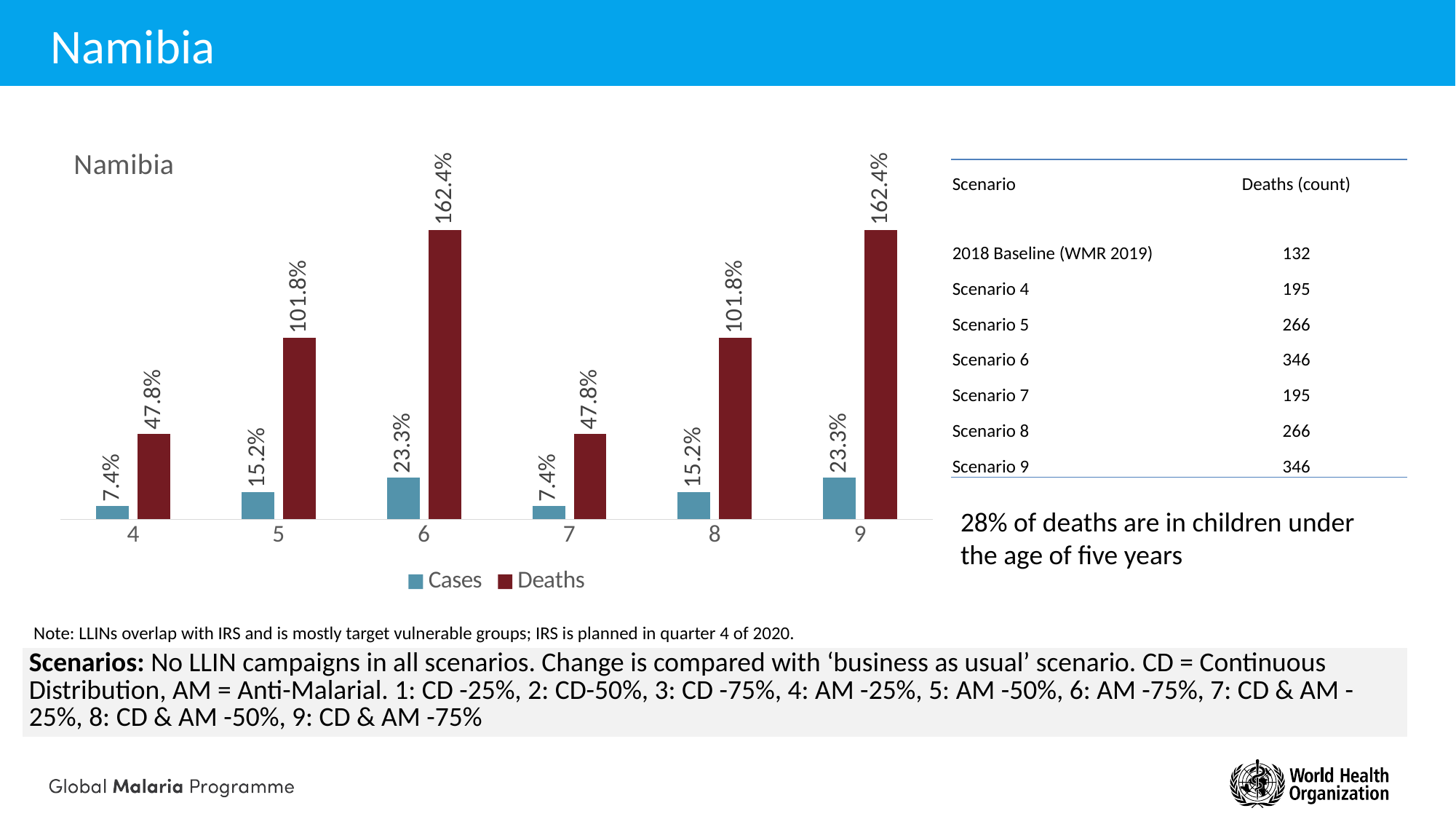
What is the Cases value for scenario 4? 7.4% What is the Deaths value for scenario 7? 47.8% What is the Deaths value for scenario 6? 162.4% How many series does the chart legend list? 2 What colour are the Deaths bars in the chart? Dark red What kind of chart is shown on the slide? Bar chart Which scenario has the lowest Deaths value? 4 and 7 (47.8%) What is the Cases value for scenario 8? 15.2% What is the difference between the Deaths value and the Cases value for scenario 5? 86.6% Which scenario has the highest Cases value? 6 and 9 (23.3%) How many scenarios are shown on the x axis of the chart? 6 Which is larger for scenario 9, the Cases value or the Deaths value? Deaths